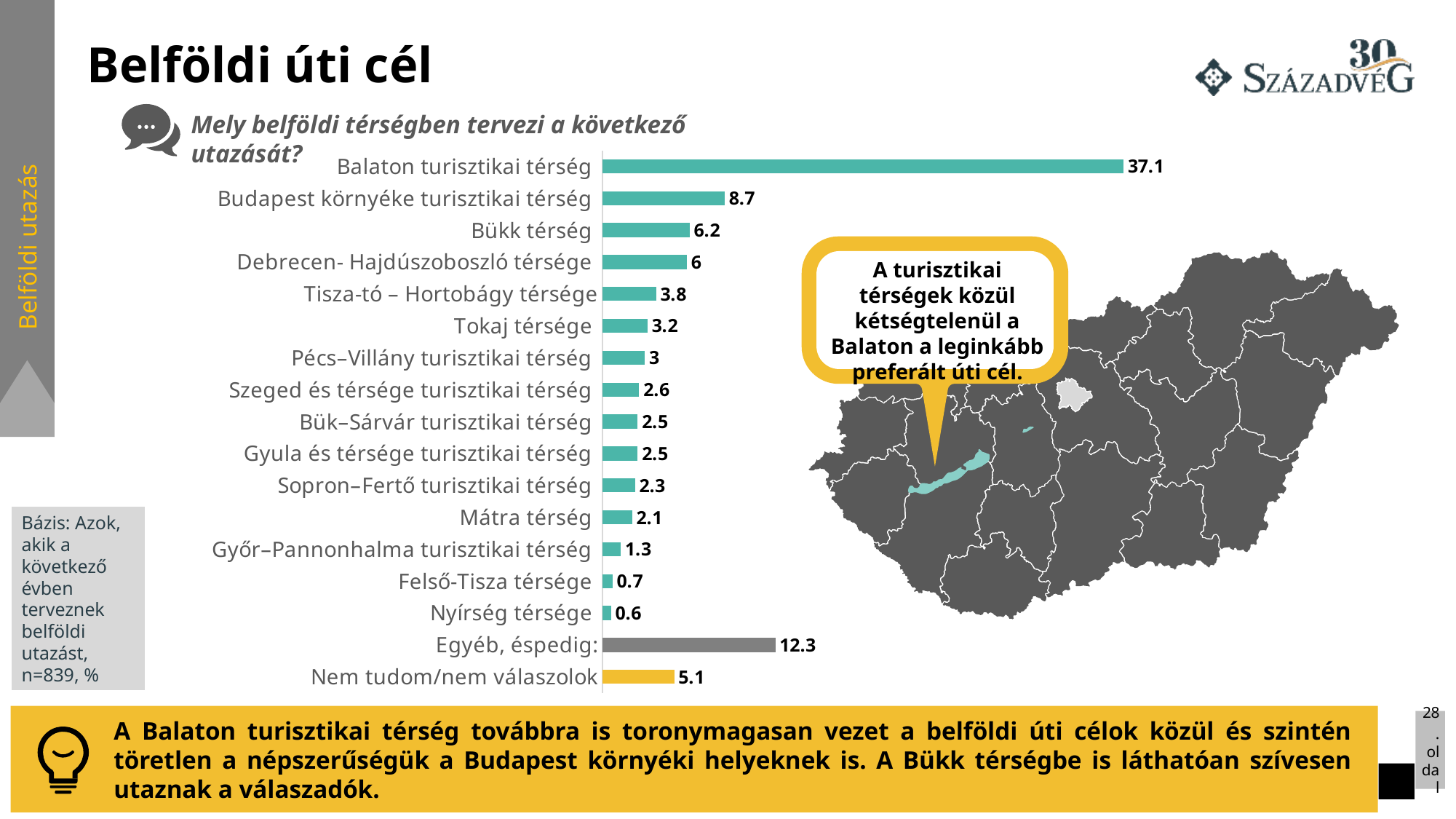
How many categories are shown in the bar chart? 17 Which is larger, the value for Tokaj térsége or the value for Mátra térség? Tokaj térsége Which category has the lowest value in the chart? Nyírség térsége What kind of chart is shown on the slide? Bar chart What colour is the bar for Nem tudom/nem válaszolok? Yellow What is the difference between the values for Debrecen- Hajdúszoboszló térsége and Tisza-tó – Hortobágy térsége? 2.2 What value is shown for Egyéb, éspedig:? 12.3 What value is shown for Nem tudom/nem válaszolok? 5.1 What value is shown for Balaton turisztikai térség? 37.1 Which category has the highest value in the chart? Balaton turisztikai térség What value is shown for Bükk térség? 6.2 What is the difference between the values for Balaton turisztikai térség and Budapest környéke turisztikai térség? 28.4